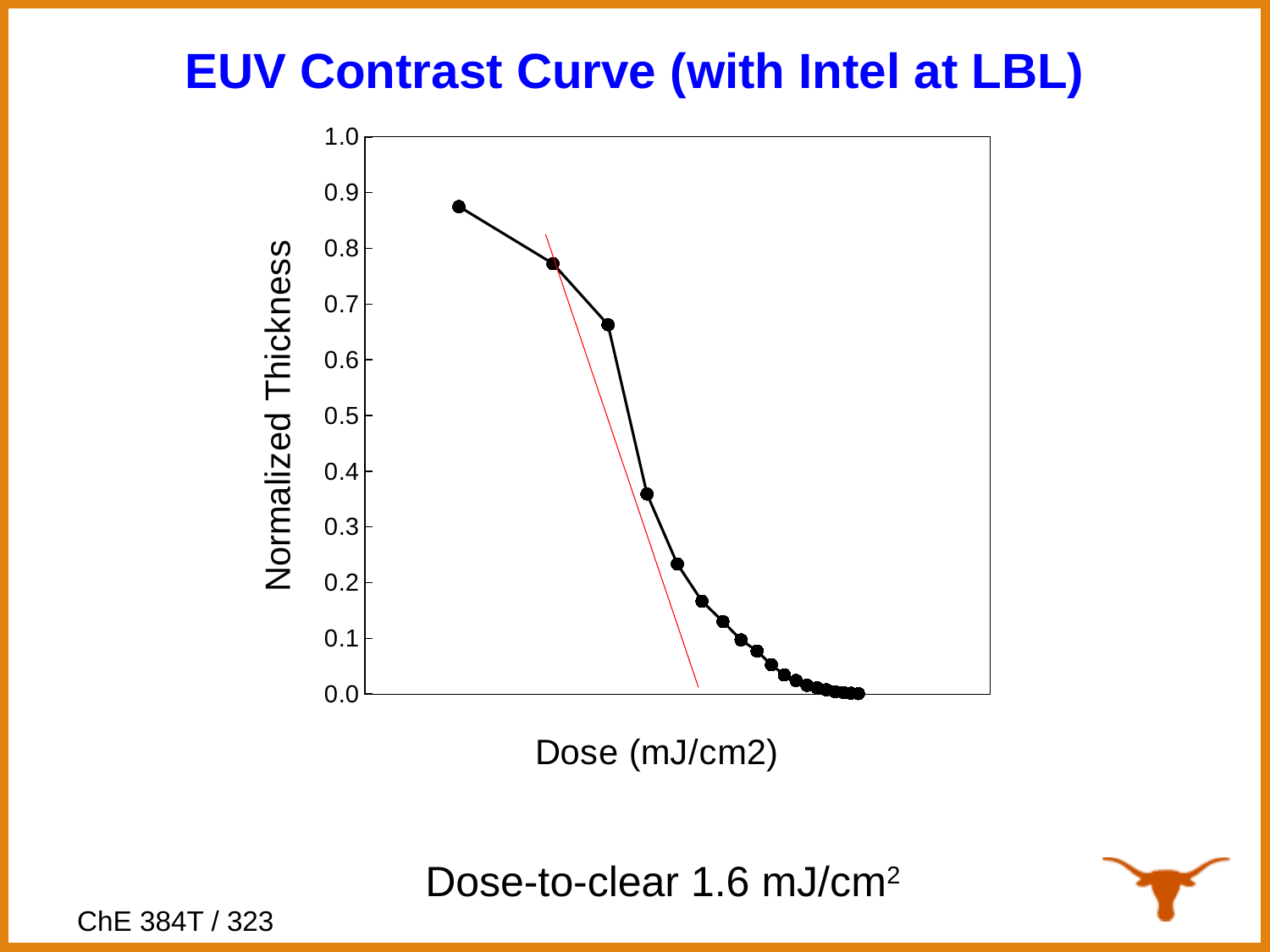
Is the normalized thickness of the third data point from the left greater or less than 0.6? greater Is the normalized thickness of the leftmost (first) data point greater or less than 0.8? greater What is the title of the chart? EUV Contrast Curve (with Intel at LBL) Is the normalized thickness of the fourth data point from the left greater or less than 0.4? less What kind of chart is shown on the slide? line chart Which data point has the highest normalized thickness, the leftmost or the rightmost? leftmost Does the normalized thickness rise or fall as dose increases along the x axis? fall What is the label of the y axis? Normalized Thickness What is the highest value shown on the y axis? 1.0